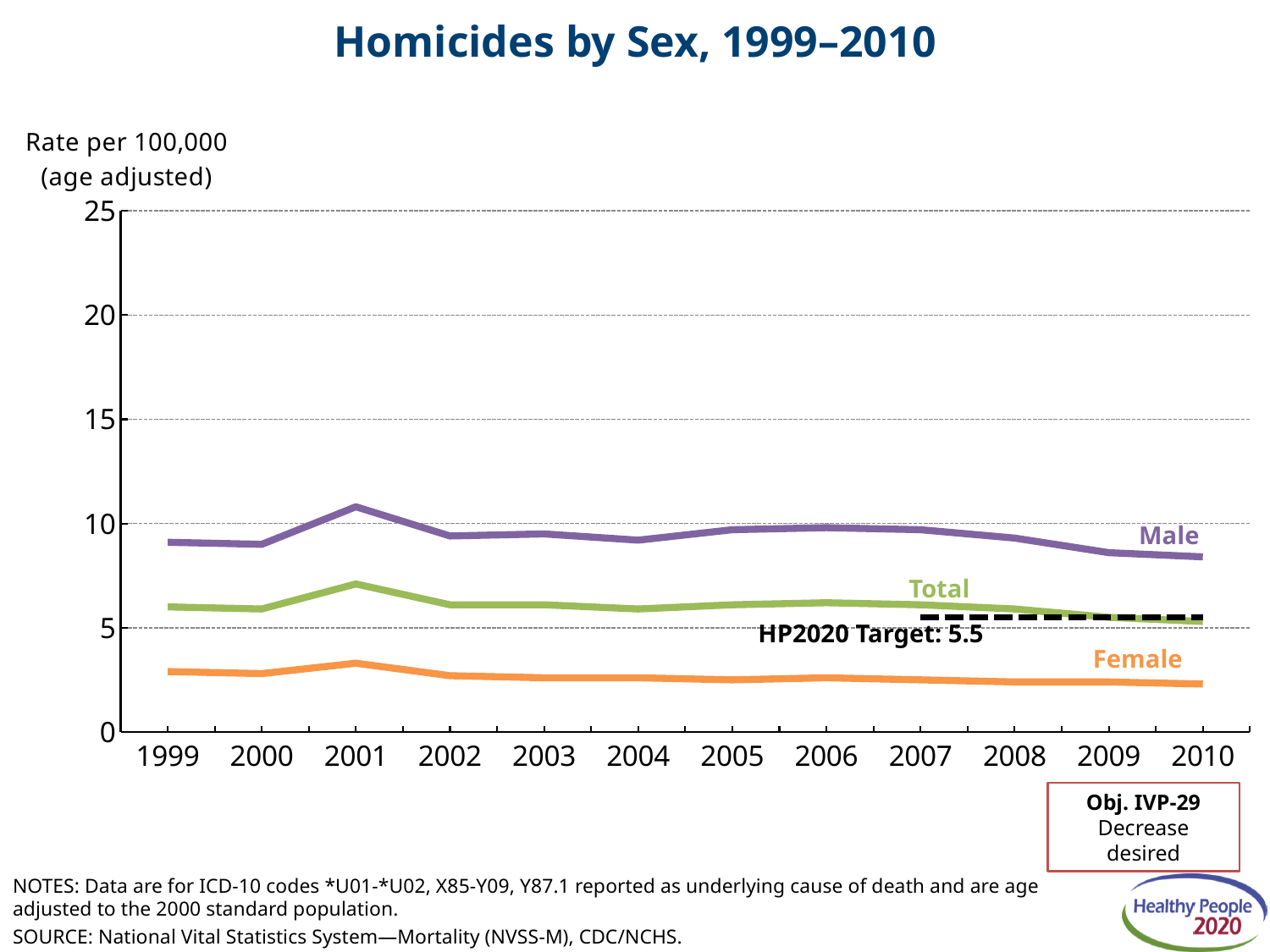
What is the title of the chart? Homicides by Sex, 1999–2010 Does the Male line rise or fall from 2006 to 2010? Fall How many years are plotted along the x axis? 12 Is the Male value in 2001 greater or less than 10? greater Which is larger in 2005, the Male rate or the Female rate? Male How many data lines (excluding the target line) are labeled on the chart? 3 What kind of chart is shown on the slide? Line chart Which line has the lowest homicide rate throughout the period? Female Is the Female value in 2010 greater or less than 5? less In which year does the Male line reach its highest value? 2001 What is the HP2020 Target value shown on the chart? 5.5 Which line has the highest homicide rate throughout the period? Male